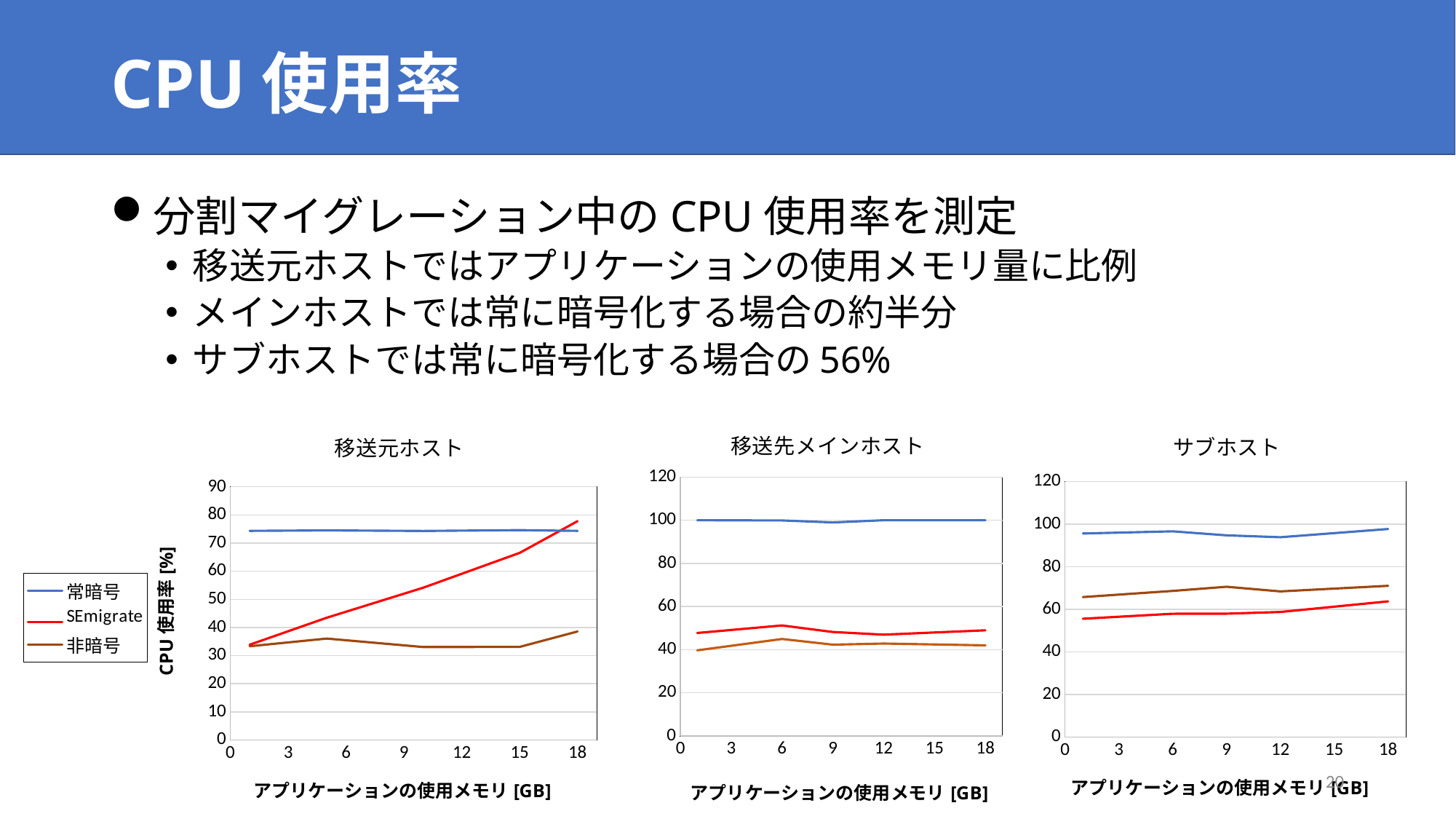
What is the x-axis label of the サブホスト chart? アプリケーションの使用メモリ [GB] How many series does the legend list for the charts? 3 In the サブホスト chart, which is larger at 18 GB, 非暗号 or SEmigrate? 非暗号 What is the y-axis label of the 移送元ホスト chart? CPU 使用率 [%] In the 移送先メインホスト chart, which is larger at 12 GB, 常暗号 or SEmigrate? 常暗号 In the 移送元ホスト chart, is the value for SEmigrate at 18 GB greater or less than 70? greater In the 移送元ホスト chart, is the value for 常暗号 at 18 GB greater or less than 70? greater In the サブホスト chart, is the value for 非暗号 at 9 GB greater or less than 60? greater In the 移送元ホスト chart, does the SEmigrate line rise or fall as application memory increases? rise What kind of chart is the 移送元ホスト chart? line chart In the 移送元ホスト chart, which series has the highest value at 6 GB? 常暗号